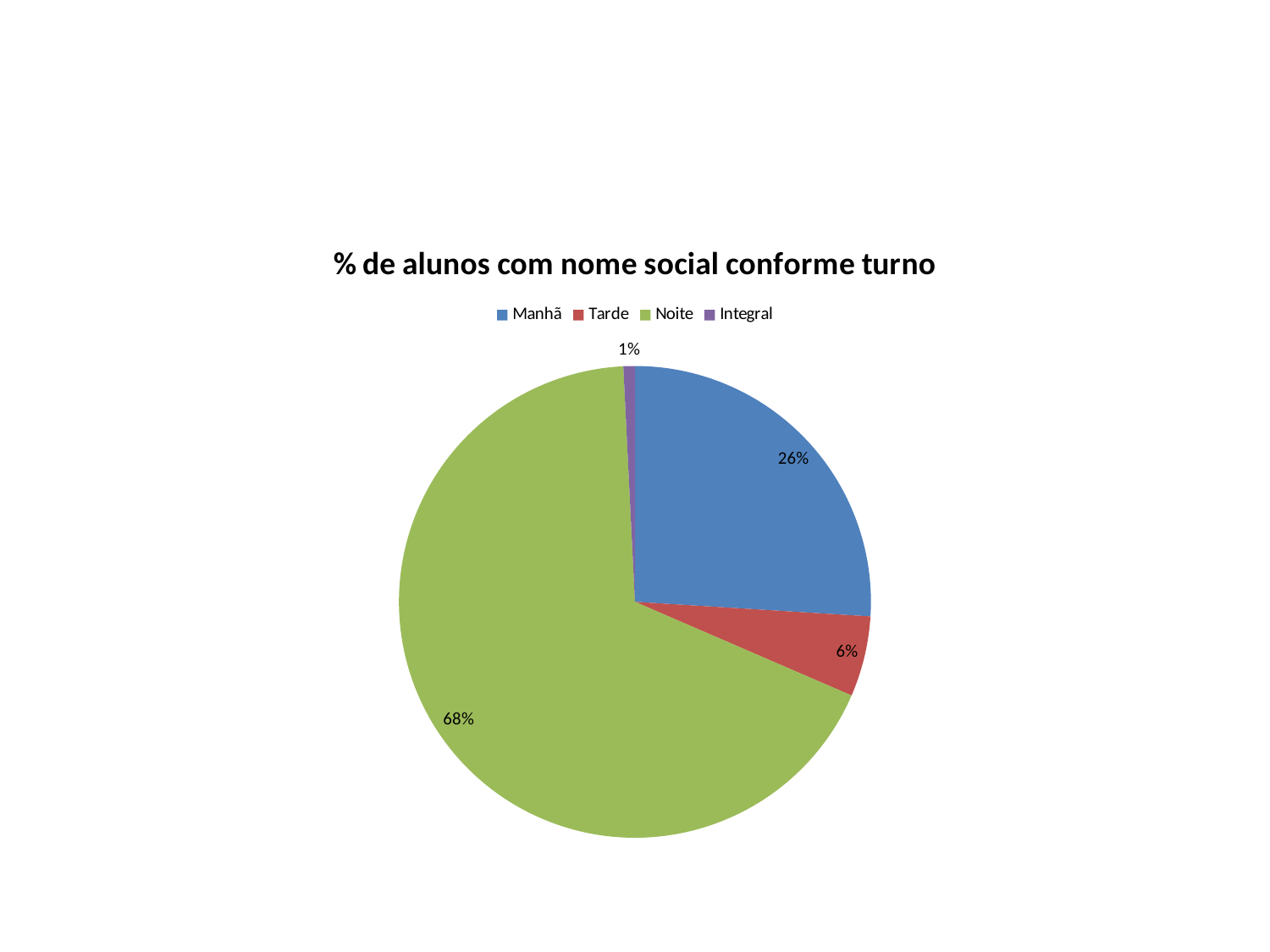
What percentage of the pie does Manhã represent? 26% Which turno has the smallest share of the pie? Integral What percentage of the pie does Noite represent? 68% What percentage of the pie does Integral represent? 1% What kind of chart is shown on the slide? Pie chart What is the difference in percentage points between the Noite and Manhã slices? 42 Which turno has the largest share of the pie? Noite What colour is the Noite slice? Green What is the title of the chart? % de alunos com nome social conforme turno Which slice is larger, Manhã or Tarde? Manhã How many slices does the pie chart have? 4 What percentage of the pie does Tarde represent? 6%